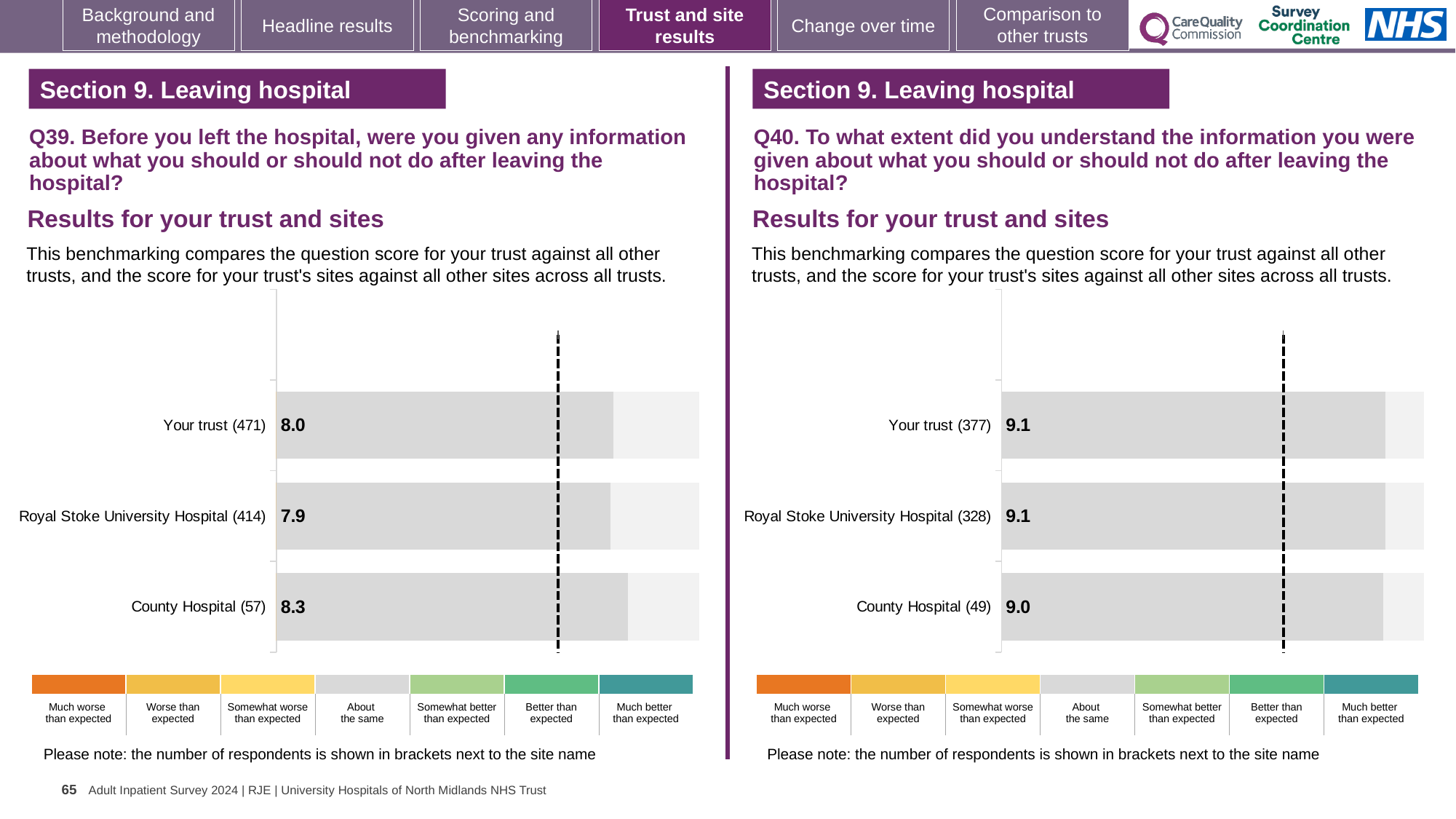
In the Q40 chart on the right, what is the score for Your trust? 9.1 In the Q39 chart on the left, what is the score for County Hospital? 8.3 How many bars are plotted in the Q40 chart on the right? 3 In the Q40 chart on the right, what is the score for County Hospital? 9.0 In the Q40 chart on the right, which has the lower score, Royal Stoke University Hospital or County Hospital? County Hospital In the Q39 chart on the left, what is the score for Your trust? 8.0 In the Q39 chart on the left, what is the difference between the County Hospital score and the Royal Stoke University Hospital score? 0.4 In the Q39 chart on the left, which site or trust has the highest score? County Hospital In the Q39 chart on the left, which site or trust has the lowest score? Royal Stoke University Hospital In the Q40 chart on the right, how many respondents are shown in brackets for Royal Stoke University Hospital? 328 What type of chart is used in the Q39 chart on the left? Bar chart In the Q39 chart on the left, what is the score for Royal Stoke University Hospital? 7.9